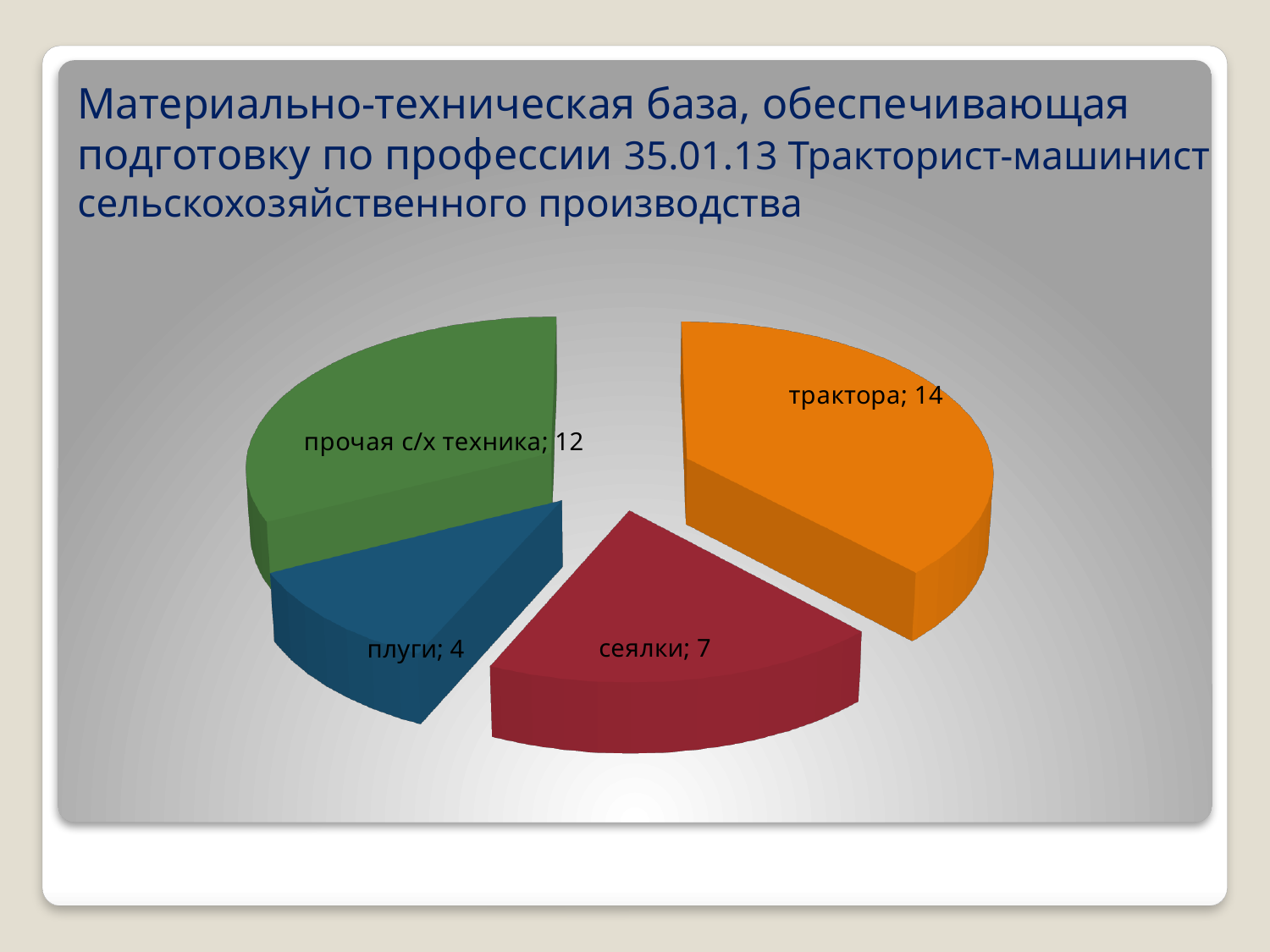
What kind of chart is shown on the slide? pie chart Which category has the smallest slice? плуги Which is larger, прочая с/х техника or сеялки? прочая с/х техника What value is shown for трактора? 14 Which category has the largest slice? трактора What value is shown for прочая с/х техника? 12 What colour is the slice for сеялки? red What is the total of all slices in the pie chart? 37 What is the difference between the values for трактора and сеялки? 7 What value is shown for сеялки? 7 What value is shown for плуги? 4 How many categories are shown in the pie chart? 4